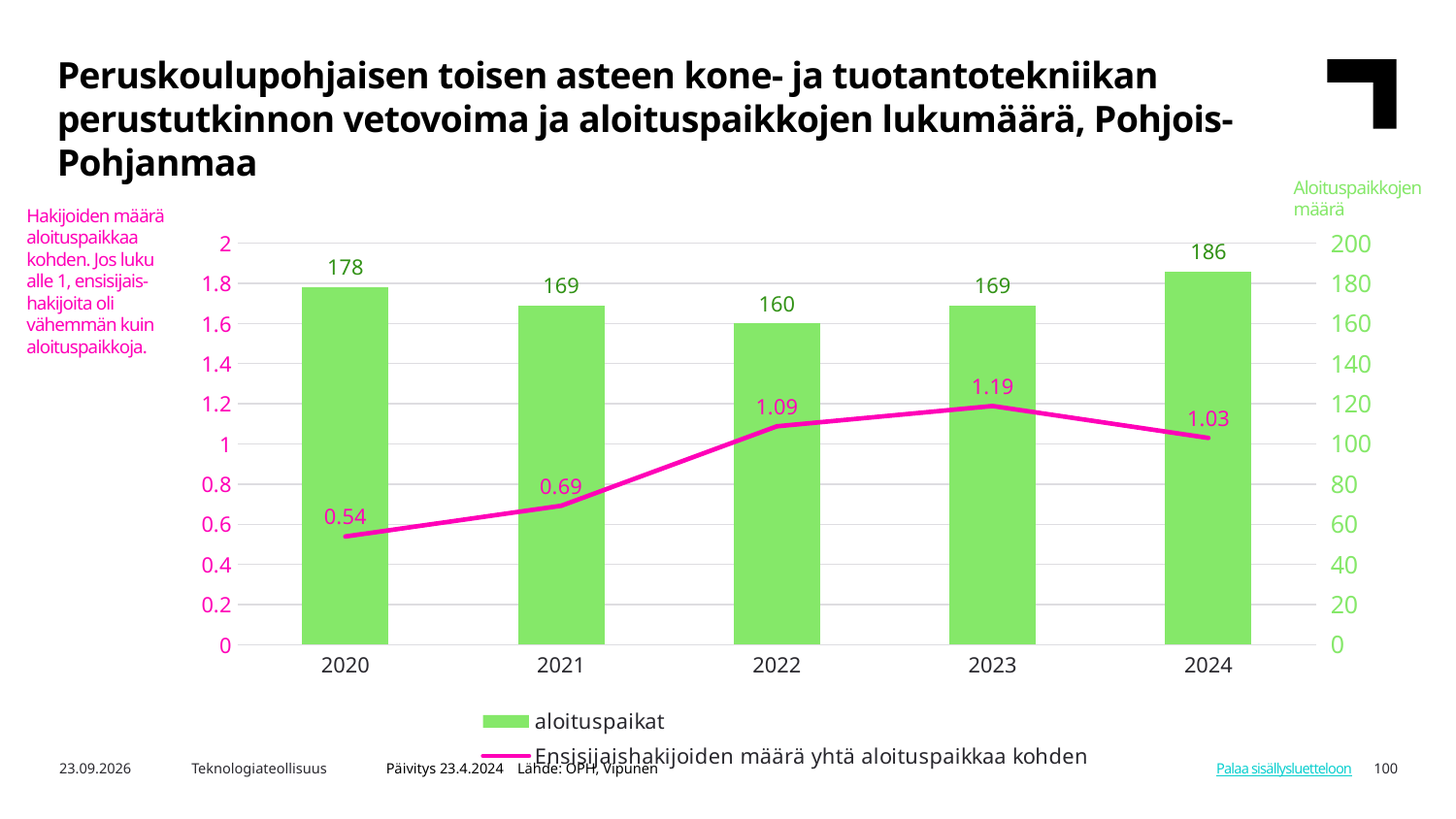
Is the value of Ensisijaishakijoiden määrä yhtä aloituspaikkaa kohden larger in 2022 or in 2024? 2022 What is the value of aloituspaikat for 2022? 160 What is the value of aloituspaikat for 2024? 186 What is the difference in aloituspaikat between 2024 and 2020? 8 How many years are shown on the x axis? 5 Which year has the highest value for Ensisijaishakijoiden määrä yhtä aloituspaikkaa kohden? 2023 Does the Ensisijaishakijoiden määrä yhtä aloituspaikkaa kohden line rise or fall from 2020 to 2023? rise What kind of chart is used for the aloituspaikat series? bar chart What colour are the aloituspaikat bars? green What is the value of Ensisijaishakijoiden määrä yhtä aloituspaikkaa kohden for 2020? 0.54 Which year has the lowest value for aloituspaikat? 2022 How many series does the legend list? 2